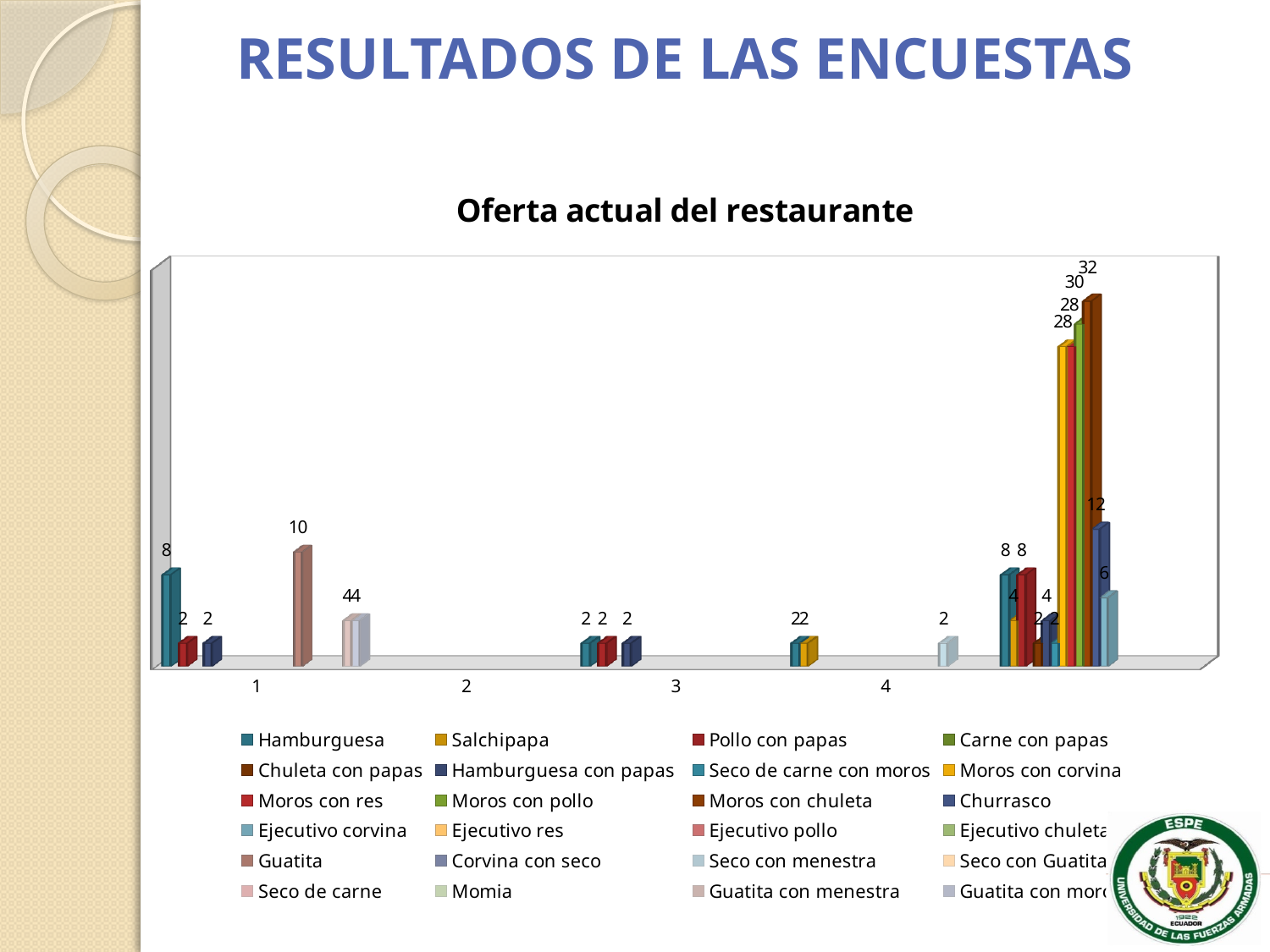
What is the value of the tallest bar in category 1? 10 Which is larger: the bar labeled 10 in category 1 or the Hamburguesa bar labeled 8 in category 1? the bar labeled 10 How many series does the chart legend list? 24 What is the difference between the two highest labeled values on the chart, 32 and 30? 2 What is the lowest value labeled on any bar in the chart? 2 What is the title of the chart? Oferta actual del restaurante What numbers label the categories on the x axis? 1, 2, 3, 4 What is the highest value labeled on any bar in the chart? 32 What is the value of the Hamburguesa bar in category 1? 8 Is the tallest bar on the chart greater or less than 30? greater What kind of chart is shown on the slide? bar chart What is the difference between the bar labeled 12 and the bar labeled 6 in the rightmost group? 6